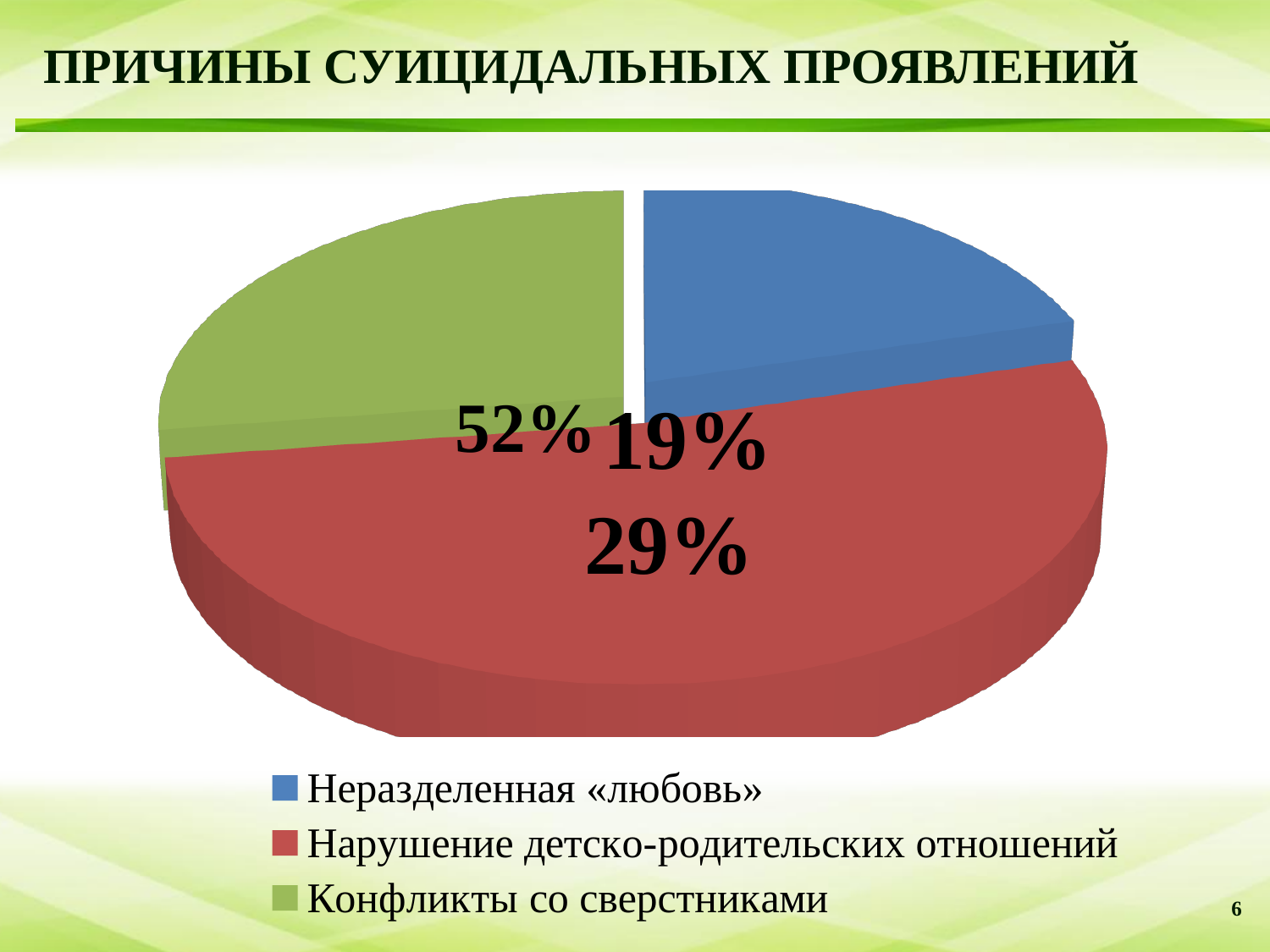
What share of the pie is 'Неразделенная «любовь»'? 19% Which category has the smallest slice of the pie? Неразделенная «любовь» How many slices does the pie chart have? 3 What is the title of the chart slide? ПРИЧИНЫ СУИЦИДАЛЬНЫХ ПРОЯВЛЕНИЙ What is the difference in percentage points between 'Нарушение детско-родительских отношений' and 'Конфликты со сверстниками'? 23 Which is larger: the slice for 'Конфликты со сверстниками' or the slice for 'Неразделенная «любовь»'? Конфликты со сверстниками Which colour represents 'Конфликты со сверстниками' in the legend? green How many entries does the legend list? 3 What share of the pie is 'Конфликты со сверстниками'? 29% What kind of chart is shown on the slide? pie chart What share of the pie is 'Нарушение детско-родительских отношений'? 52% Which category has the largest slice of the pie? Нарушение детско-родительских отношений